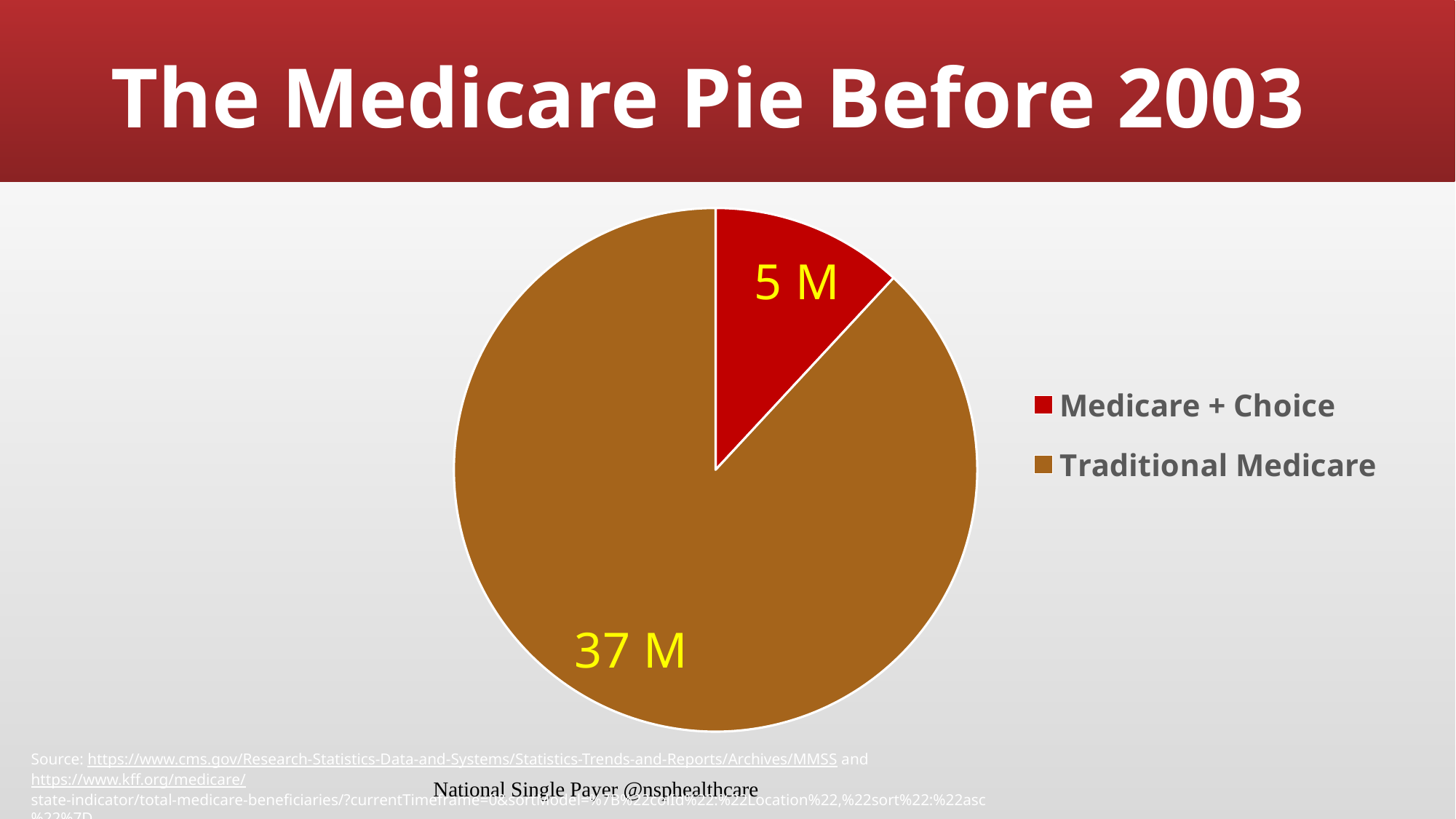
How many entries does the legend list? 2 What is the total of the two slices in the pie chart? 42 M What is the difference between Traditional Medicare and Medicare + Choice? 32 M What kind of chart is shown on the slide? pie chart What is the value for Medicare + Choice? 5 M How many slices does the pie chart have? 2 What is the title of the slide containing the pie chart? The Medicare Pie Before 2003 Which is larger, Medicare + Choice or Traditional Medicare? Traditional Medicare Which slice is the largest? Traditional Medicare What is the value for Traditional Medicare? 37 M Which slice is the smallest? Medicare + Choice What colour is the Medicare + Choice slice? red